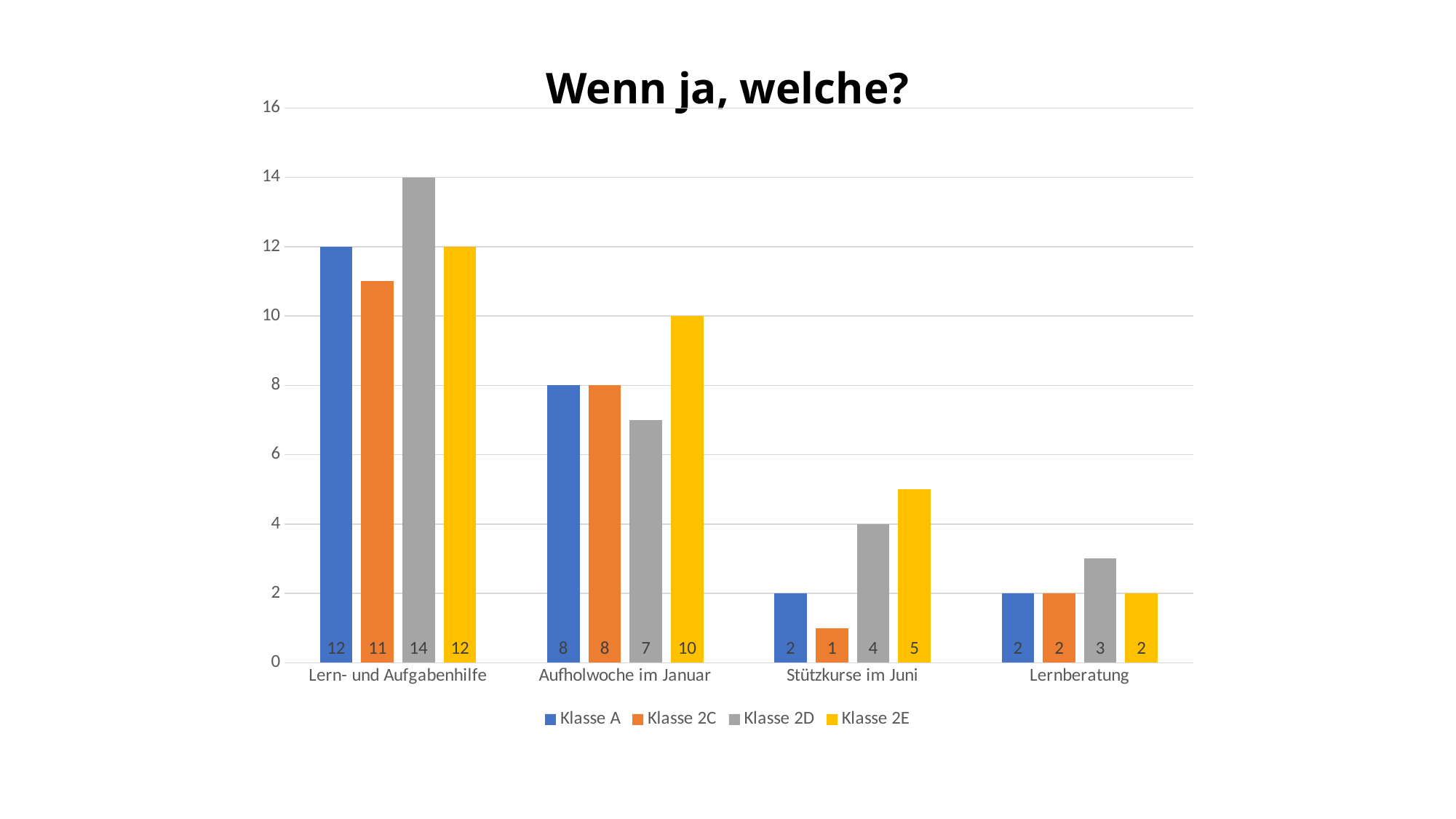
Which series has the highest value in the Lern- und Aufgabenhilfe category? Klasse 2D What is the title of the chart? Wenn ja, welche? What is the difference between the Klasse 2E and Klasse 2D values in the Aufholwoche im Januar category? 3 Which is larger: the Klasse A value for Lern- und Aufgabenhilfe or the Klasse A value for Aufholwoche im Januar? Lern- und Aufgabenhilfe What is the value for Klasse 2D in the Lern- und Aufgabenhilfe category? 14 How many categories are shown on the x axis? 4 Is the value for Klasse 2D in the Lern- und Aufgabenhilfe category greater or less than 12? greater What kind of chart is shown on the slide? Bar chart How many series does the legend list? 4 What is the value for Klasse 2C in the Stützkurse im Juni category? 1 Which series has the lowest value in the Stützkurse im Juni category? Klasse 2C What is the value for Klasse 2E in the Aufholwoche im Januar category? 10